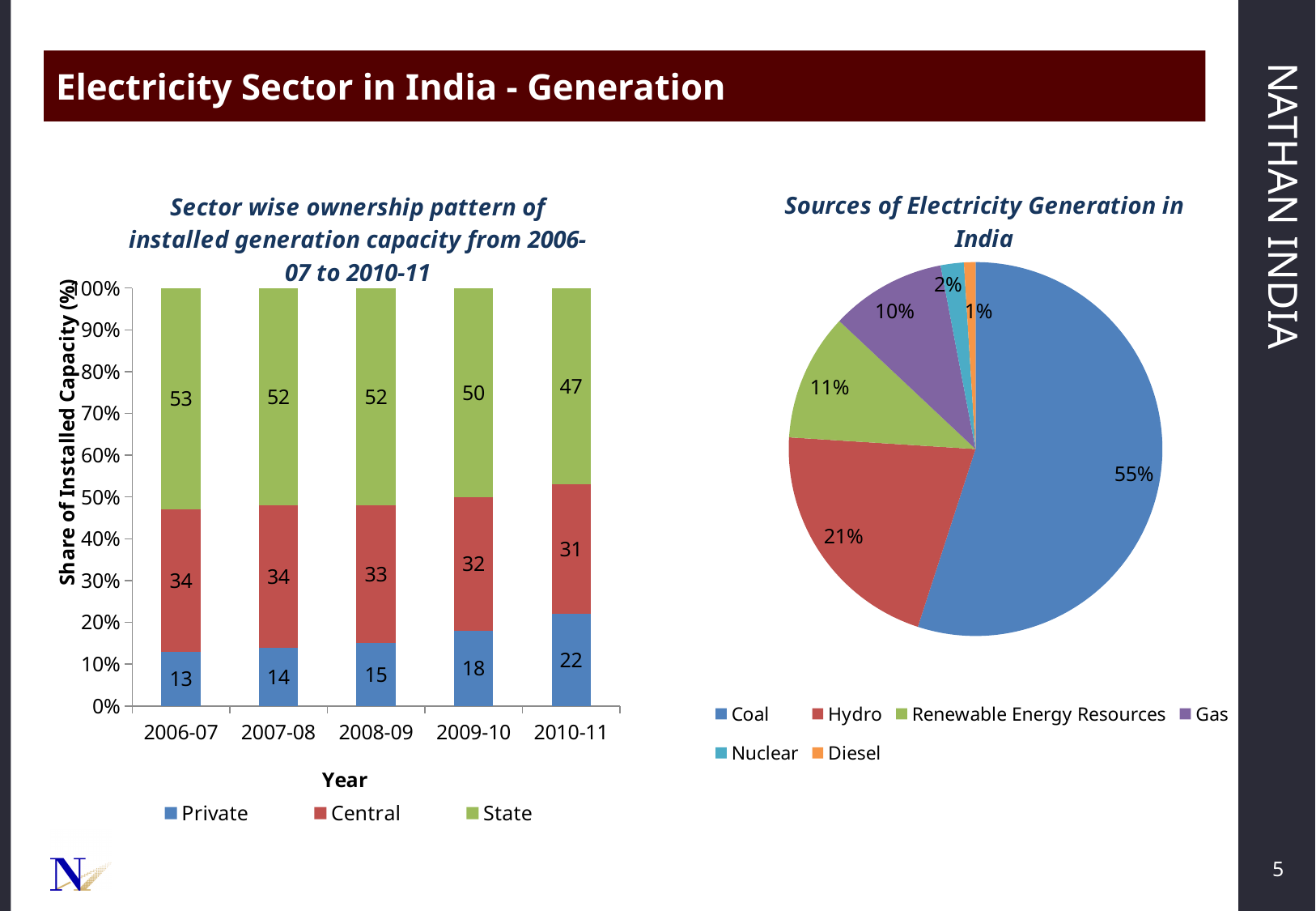
In the 'Sources of Electricity Generation in India' pie chart, which source has the smallest share? Diesel In the 'Sector wise ownership pattern' chart, what is the value for Private in 2010-11? 22 In the 'Sector wise ownership pattern' chart, what is the difference between the Private values for 2010-11 and 2006-07? 9 In the 'Sector wise ownership pattern' chart, in which year is the Private share highest? 2010-11 In the 'Sector wise ownership pattern' chart, in which year is the State share lowest? 2010-11 In the 'Sector wise ownership pattern' chart, what is the value for State in 2006-07? 53 What kind of chart is the 'Sector wise ownership pattern' chart? stacked bar chart In the 'Sector wise ownership pattern' chart, what is the value for Central in 2008-09? 33 In the 'Sector wise ownership pattern' chart, does the Private share rise or fall from 2006-07 to 2010-11? rise How many series does the legend of the 'Sector wise ownership pattern' chart list? 3 In the 'Sources of Electricity Generation in India' pie chart, what share does Coal have? 55% In the 'Sources of Electricity Generation in India' pie chart, which is larger, Hydro or Gas? Hydro